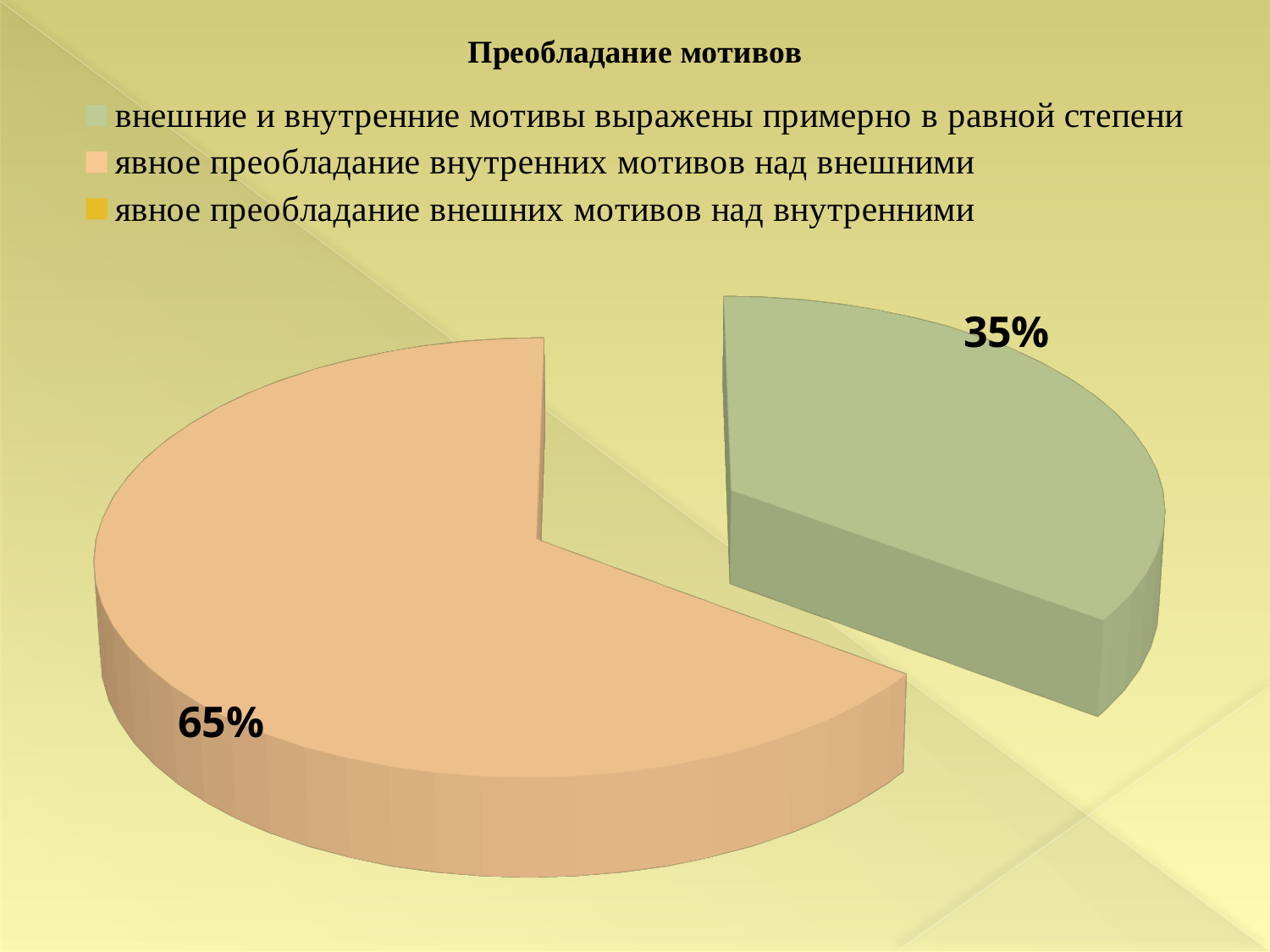
How many entries does the legend list? 3 What percentage is shown for "внешние и внутренние мотивы выражены примерно в равной степени"? 35% Which category has the largest slice of the pie? явное преобладание внутренних мотивов над внешними What share of the pie does the green slice represent? 35% What kind of chart is shown on the slide? pie chart Is the value for "явное преобладание внутренних мотивов над внешними" greater or less than 50%? greater Which of the two labelled slices is smaller? внешние и внутренние мотивы выражены примерно в равной степени What is the title of the chart? Преобладание мотивов What percentage is shown for "явное преобладание внутренних мотивов над внешними"? 65% How many slices are visible in the pie chart? 2 What is the difference in percentage points between the 65% slice and the 35% slice? 30% Which is larger: the slice for "явное преобладание внутренних мотивов над внешними" or the slice for "внешние и внутренние мотивы выражены примерно в равной степени"? явное преобладание внутренних мотивов над внешними